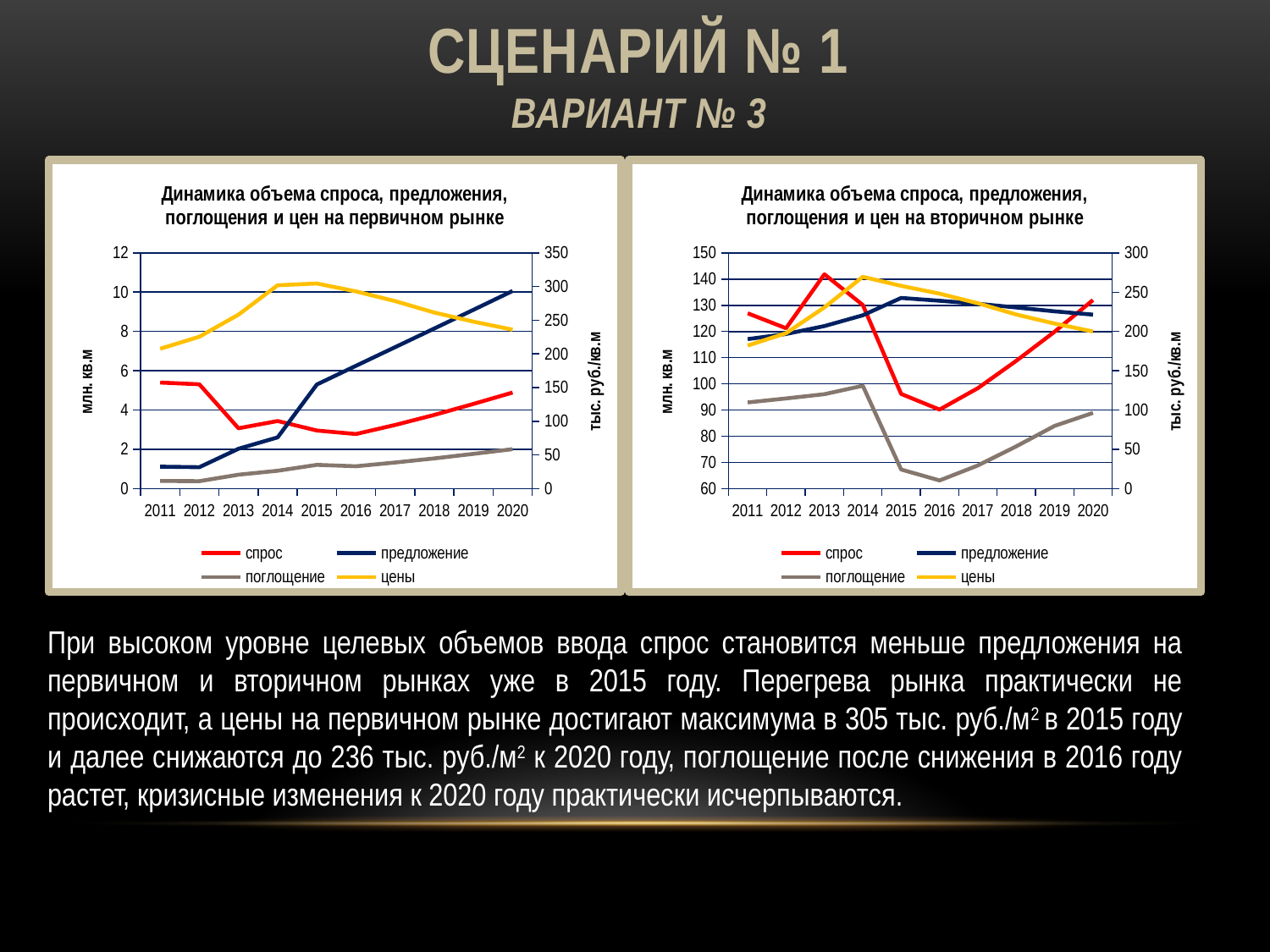
How many series does the legend of the right chart (вторичный рынок) list? 4 In the right chart (вторичный рынок), is the value of 'поглощение' in 2016 greater or less than 70 млн. кв.м? less In the right chart (вторичный рынок), is the value of 'спрос' in 2016 greater or less than 100 млн. кв.м? less In the left chart (первичный рынок), does 'предложение' rise or fall from 2011 to 2020? rise In the right chart (вторичный рынок), in which year is 'поглощение' lowest? 2016 In the left chart (первичный рынок), is the value of 'спрос' in 2011 greater or less than 4 млн. кв.м? greater What kind of chart is the left chart, 'Динамика объема спроса, предложения, поглощения и цен на первичном рынке'? line chart In the right chart (вторичный рынок), which is larger in 2016: 'спрос' or 'предложение'? предложение In the left chart (первичный рынок), in which year is 'предложение' highest? 2020 How many years are plotted along the x axis of the left chart (первичный рынок)? 10